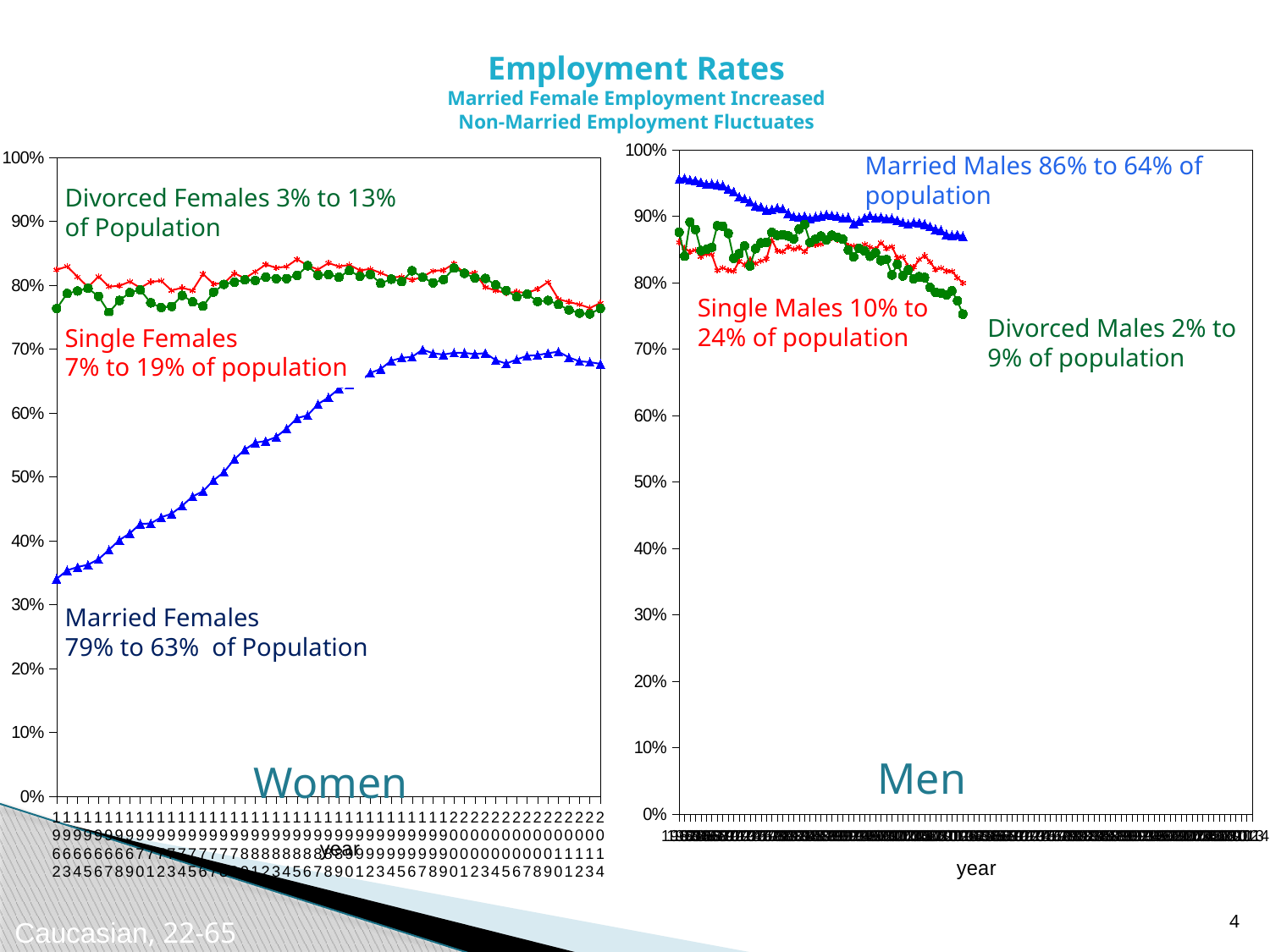
On the Women chart, which series has the higher value at the start of the period, Single Females or Married Females? Single Females On the Women chart, is the last value for Married Females greater or less than 60%? greater What is the x-axis label on the Men chart? year On the Men chart, which series has the higher value at the end of the period, Married Males or Divorced Males? Married Males On the Women chart, does the Married Females line rise or fall over the years shown? rise On the Men chart, is the last value for Divorced Males greater or less than 80%? less On the Women chart, is the first value for Married Females greater or less than 40%? less How many series are plotted on the Men chart on the right? 3 What kind of chart is the Women chart on the left? line chart What is the main title of the slide's charts? Employment Rates On the Men chart, does the Married Males line rise or fall over the years shown? fall